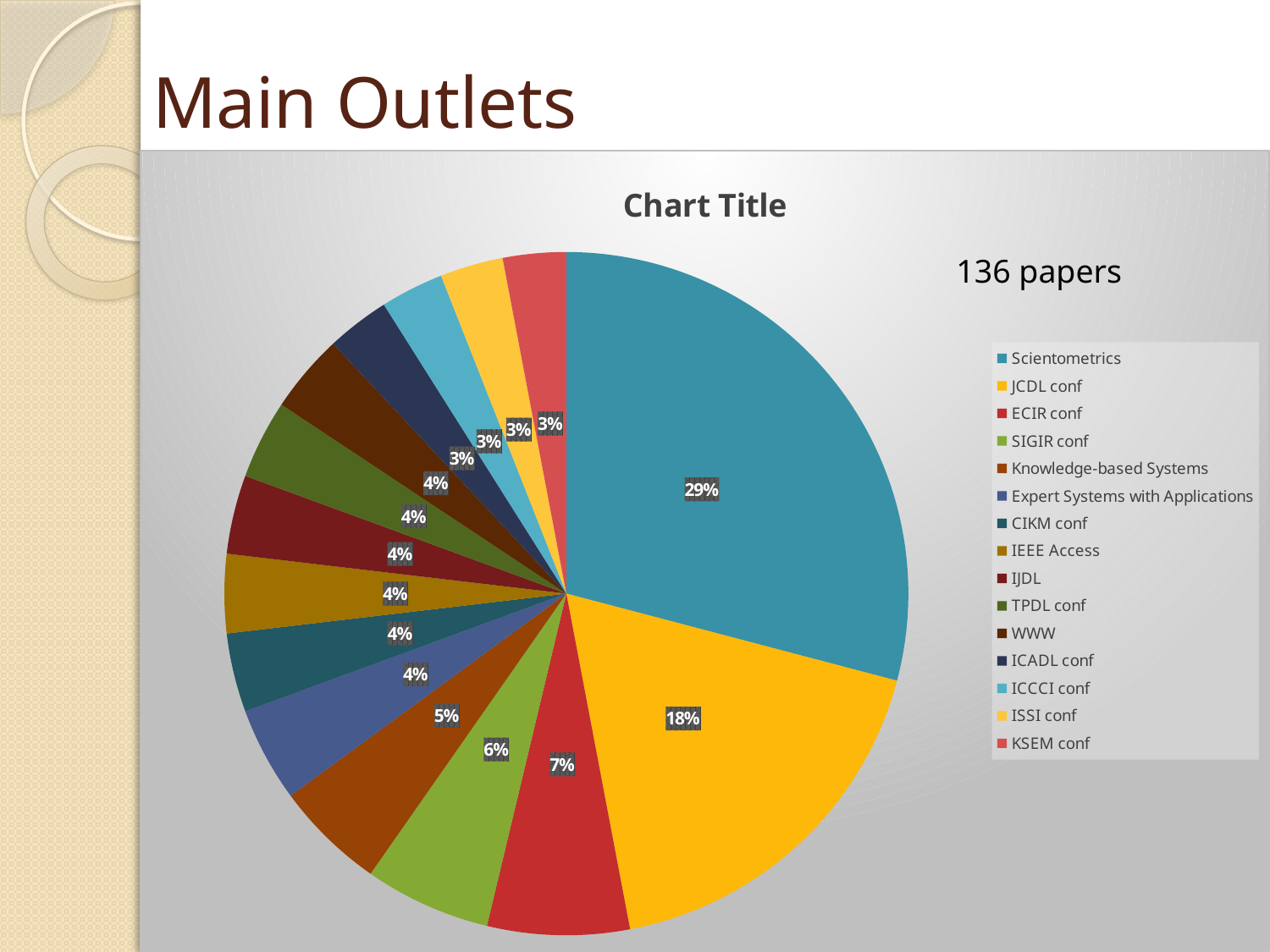
Which slice is larger, ECIR conf or SIGIR conf? ECIR conf What is the title shown above the pie chart? Chart Title What share of the pie does ECIR conf account for? 7% What share of the pie does Knowledge-based Systems account for? 5% What share of the pie does SIGIR conf account for? 6% Which outlet has the largest slice of the pie? Scientometrics What is the difference in percentage points between the Scientometrics slice and the JCDL conf slice? 11 percentage points What type of chart is shown on the slide? pie chart How many papers does the slide say the chart covers? 136 papers How many slices (outlets) does the pie chart have? 15